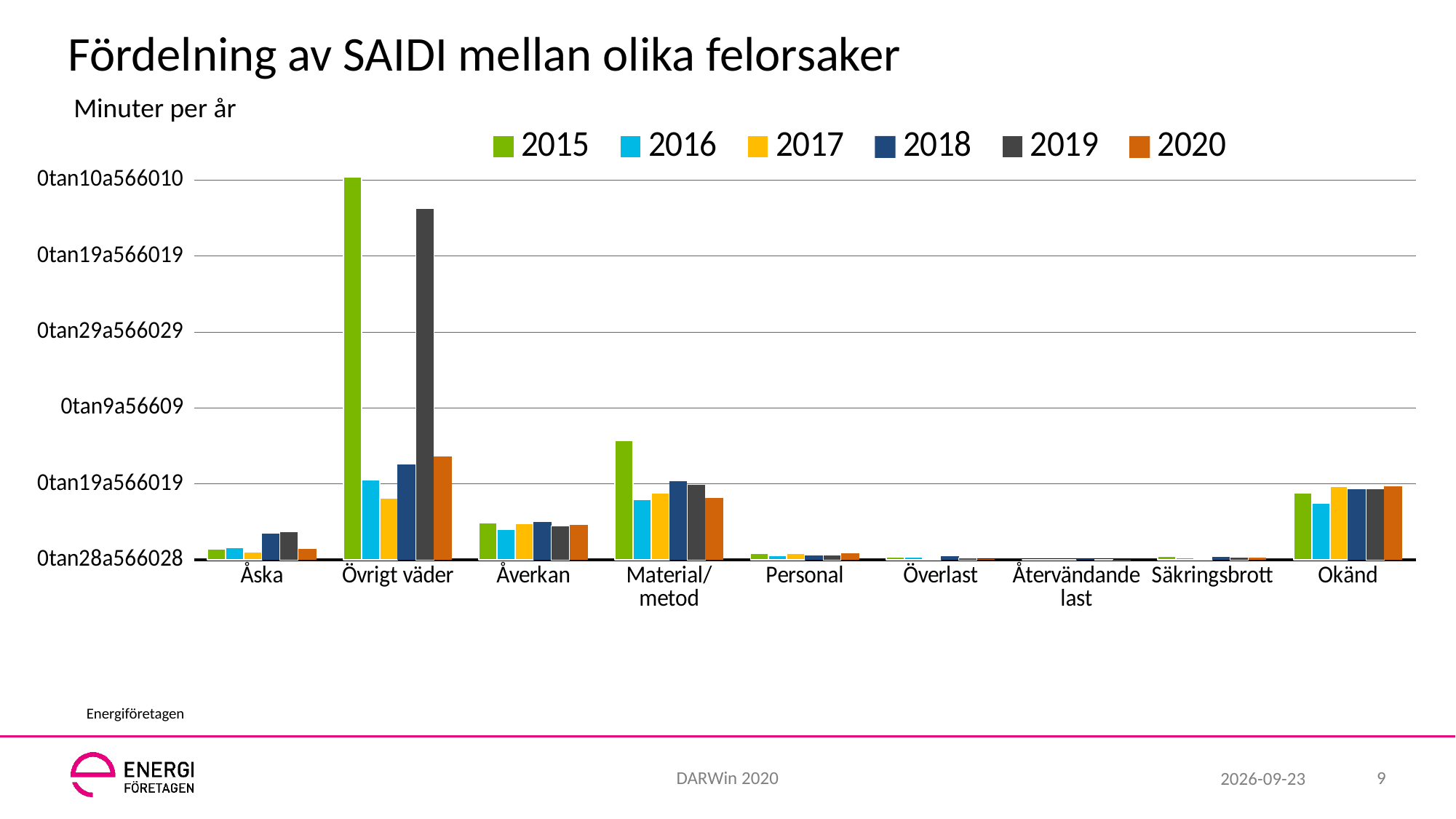
Within the Övrigt väder category, which year has the highest value? 2015 For Övrigt väder, which is larger: the 2015 value or the 2016 value? 2015 For Övrigt väder, which is larger: the 2019 value or the 2020 value? 2019 For Material/metod, which is larger: the 2015 value or the 2020 value? 2015 What kind of chart is shown on the slide? Bar chart What is the title of the chart? Fördelning av SAIDI mellan olika felorsaker What unit label is shown above the chart's y axis? Minuter per år Within the Material/metod category, which year has the highest value? 2015 How many series does the legend list? 6 How many fault-cause categories are shown on the x axis? 9 Which category contains the tallest bar in the chart? Övrigt väder